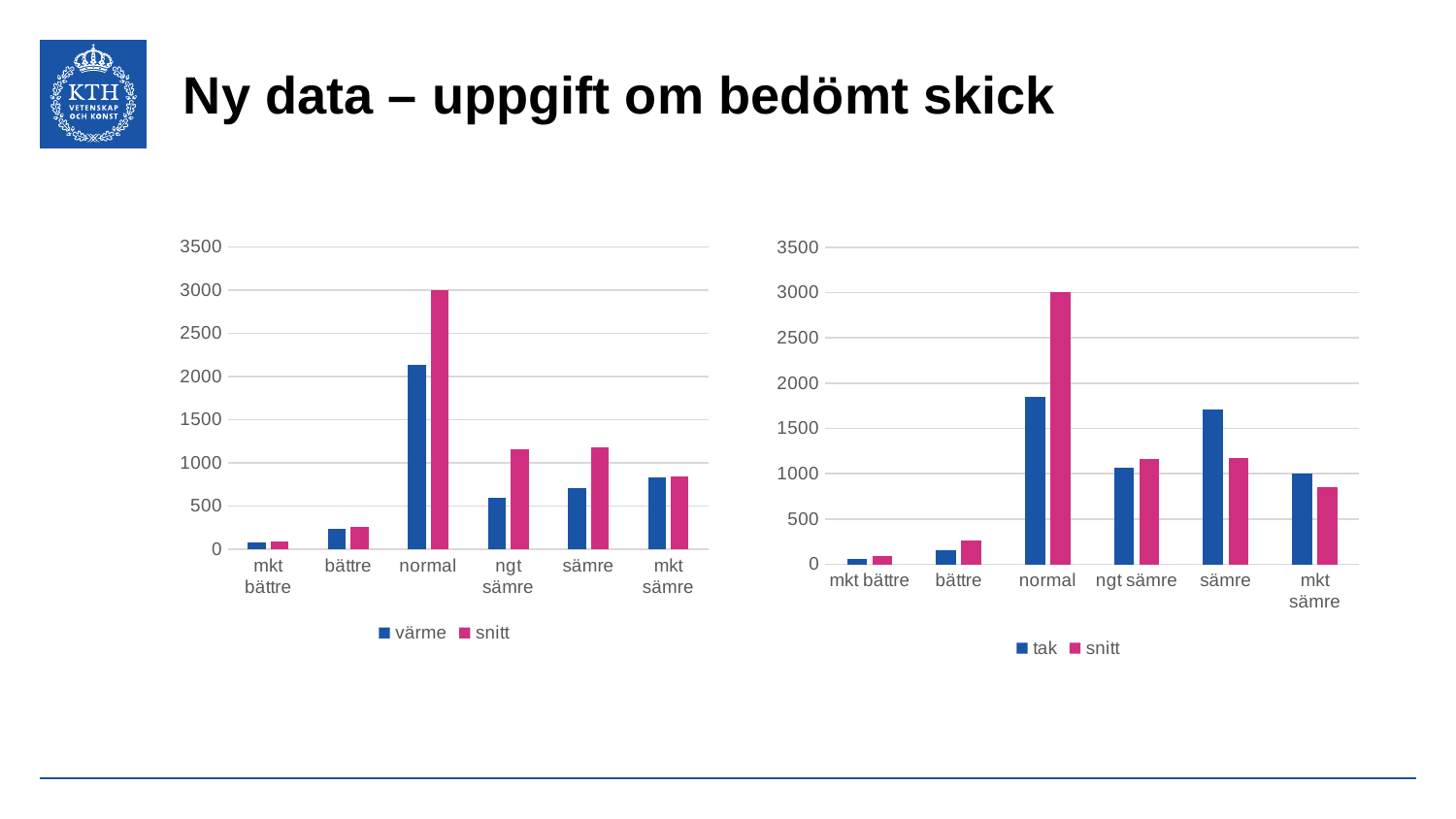
What kind of chart is the left chart with the legend 'värme' and 'snitt'? bar chart What are the two series named in the legend of the right chart? tak and snitt In the right chart, which is larger for 'sämre': 'tak' or 'snitt'? tak In the right chart, which category has the lowest 'tak' value? mkt bättre In the right chart, is the 'snitt' value for 'normal' greater or less than 2500? greater In the left chart, is the 'värme' value for 'normal' greater or less than 2000? greater How many categories are shown on the x axis of the right chart (legend 'tak' and 'snitt')? 6 In the left chart, is the 'värme' value for 'bättre' greater or less than 500? less How many series does the legend of the left chart list? 2 In the left chart, which category has the highest 'snitt' value? normal In the left chart, which is larger for 'ngt sämre': 'värme' or 'snitt'? snitt